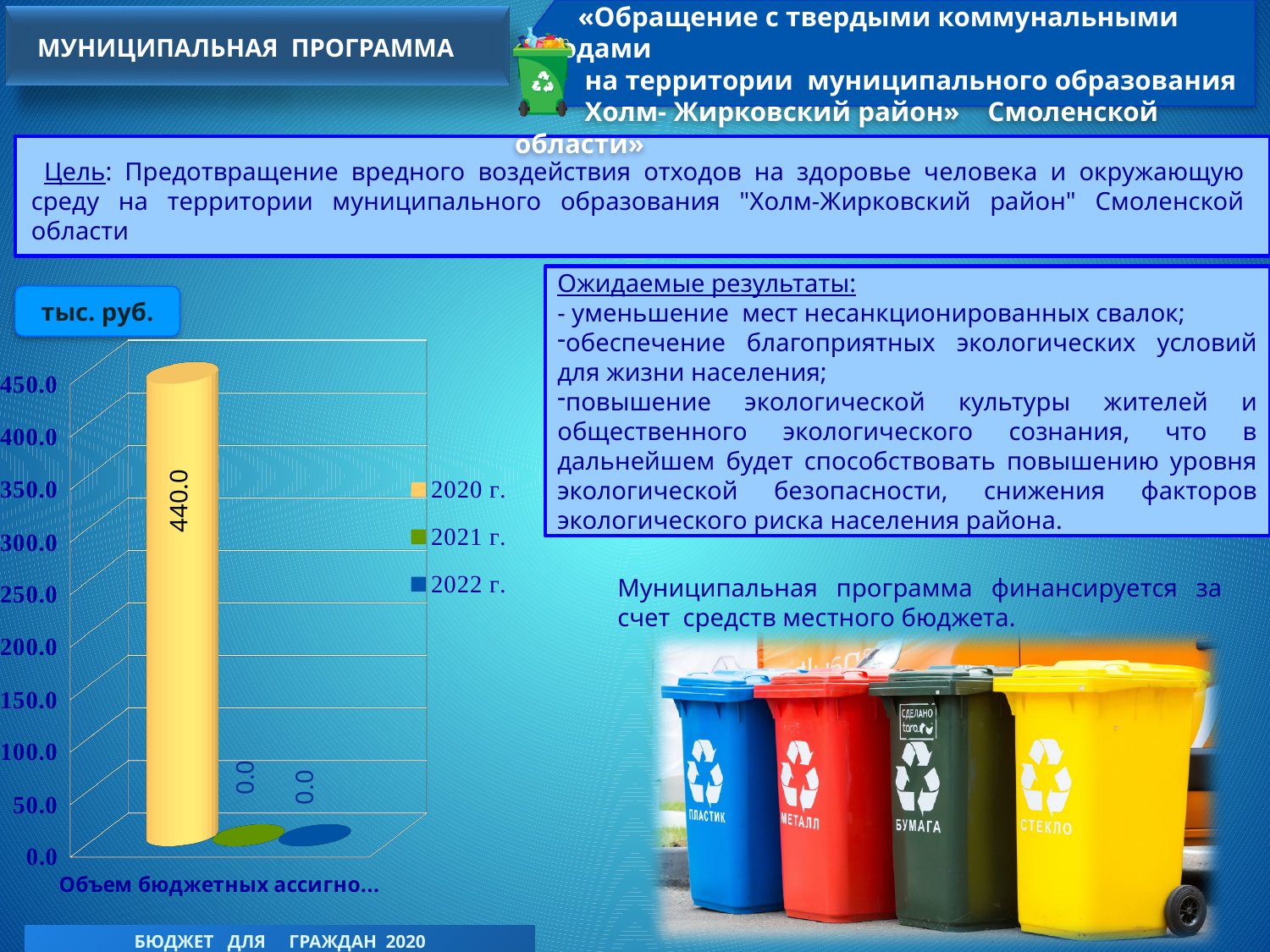
What is the value for the 2021 г. series in the chart? 0.0 What unit of measurement is indicated for the chart values? тыс. руб. What is the highest tick value shown on the chart's vertical axis? 450.0 Which is larger, the value for 2020 г. or the value for 2022 г.? 2020 г. What kind of chart is shown on the slide? bar chart What is the value for the 2020 г. series in the chart? 440.0 What is the value for the 2022 г. series in the chart? 0.0 Which series has the highest value in the chart? 2020 г. How many series does the chart legend list? 3 What is the difference between the 2020 г. value and the 2021 г. value? 440.0 Is the value for 2020 г. greater or less than 400.0? greater What is the total of the values for 2020 г., 2021 г. and 2022 г. in the chart? 440.0